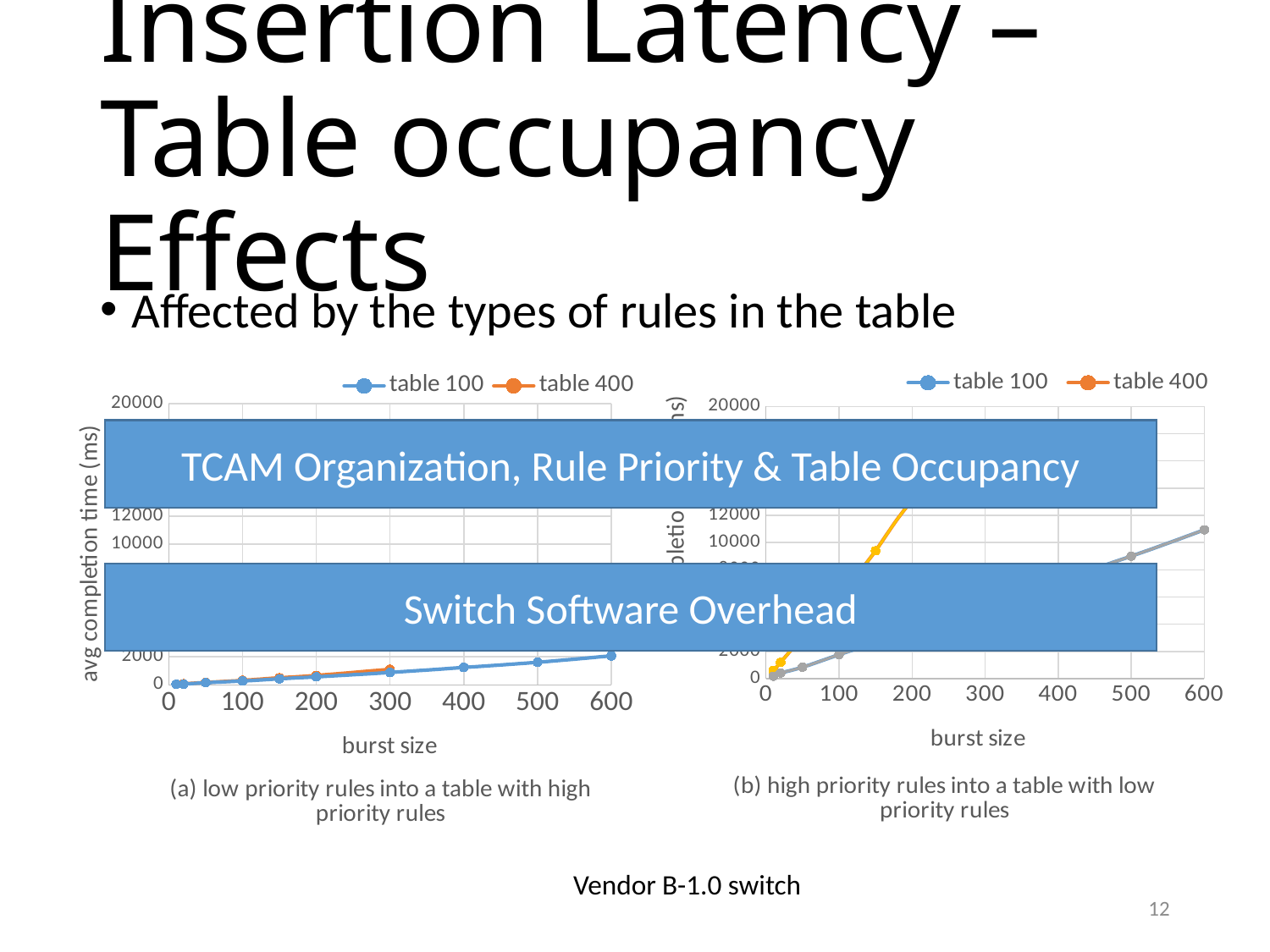
In chart (a), does the avg completion time for table 100 rise or fall as burst size increases? rise In chart (a), is the value for table 100 at burst size 300 greater or less than 2000? less How many series does the legend of chart (a) list? 2 How many series does the legend of chart (b), on the right, list? 2 In chart (b), does the avg completion time for table 100 rise or fall as burst size increases? rise In chart (a), is the value for table 100 at burst size 600 greater or less than 4000? less What is the x-axis title of chart (a)? burst size What kind of chart is chart (a), on the left of the slide? line chart What is the y-axis title of chart (a)? avg completion time (ms) In chart (b), is the value for table 100 at burst size 600 greater or less than 2000? greater What is the highest tick label on the y axis of chart (b)? 20000